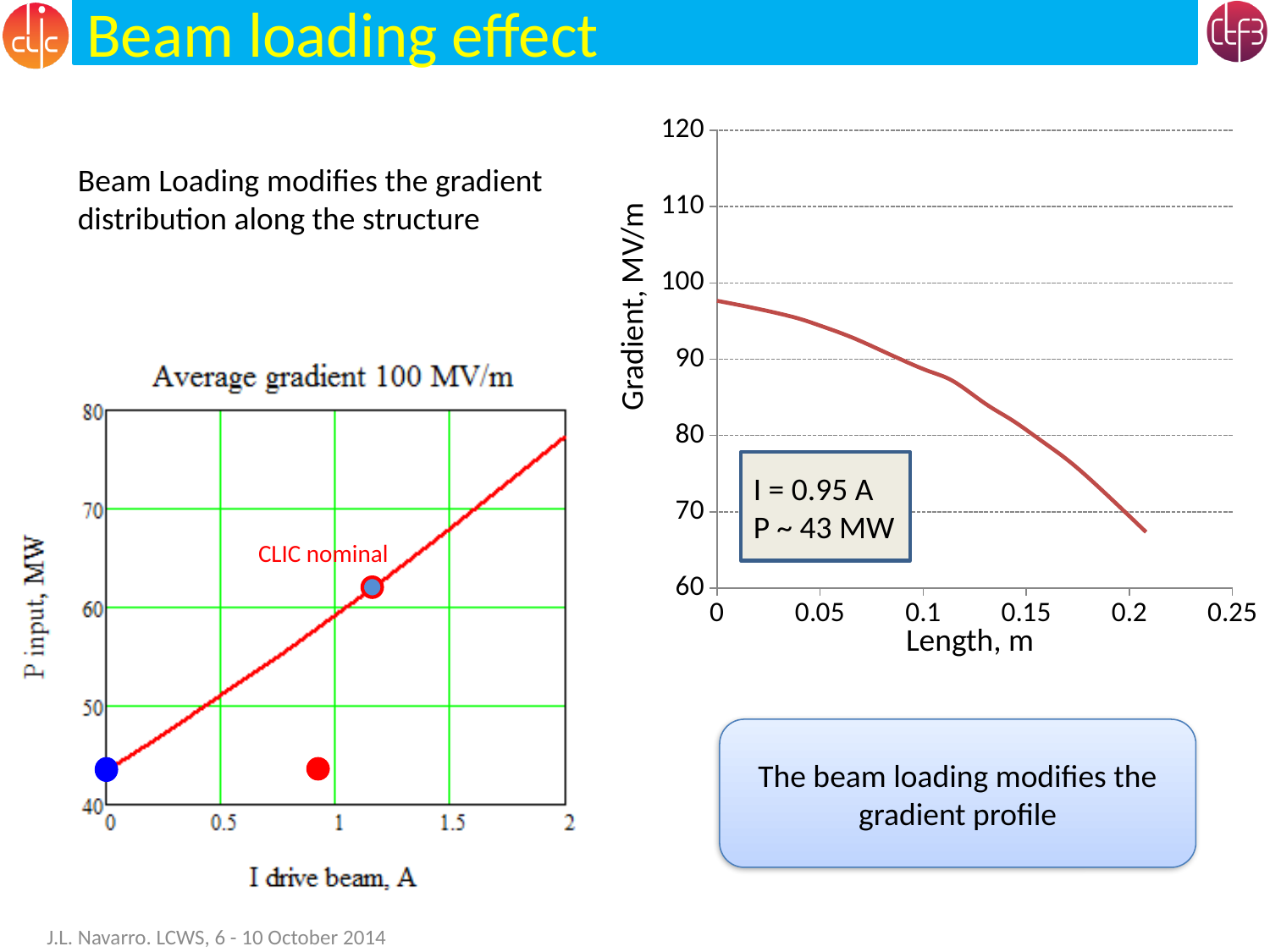
On the left chart (Average gradient 100 MV/m), is the P input at I drive beam = 2 A greater or less than 70 MW? greater On the right chart, what is the label of the vertical axis? Gradient, MV/m What kind of chart is the chart on the right of the slide (Gradient vs Length)? line chart On the right chart, what is the label of the horizontal axis? Length, m On the left chart (Average gradient 100 MV/m), is the P input at I drive beam = 0 A greater or less than 50 MW? less What is the title of the chart on the left of the slide? Average gradient 100 MV/m On the left chart (Average gradient 100 MV/m), does P input rise or fall as I drive beam increases? rise On the right chart, is the gradient at length 0.05 m greater or less than 90 MV/m? greater On the right chart, does the gradient rise or fall as the length increases? fall On the right chart, what beam current is stated in the annotation box? I = 0.95 A